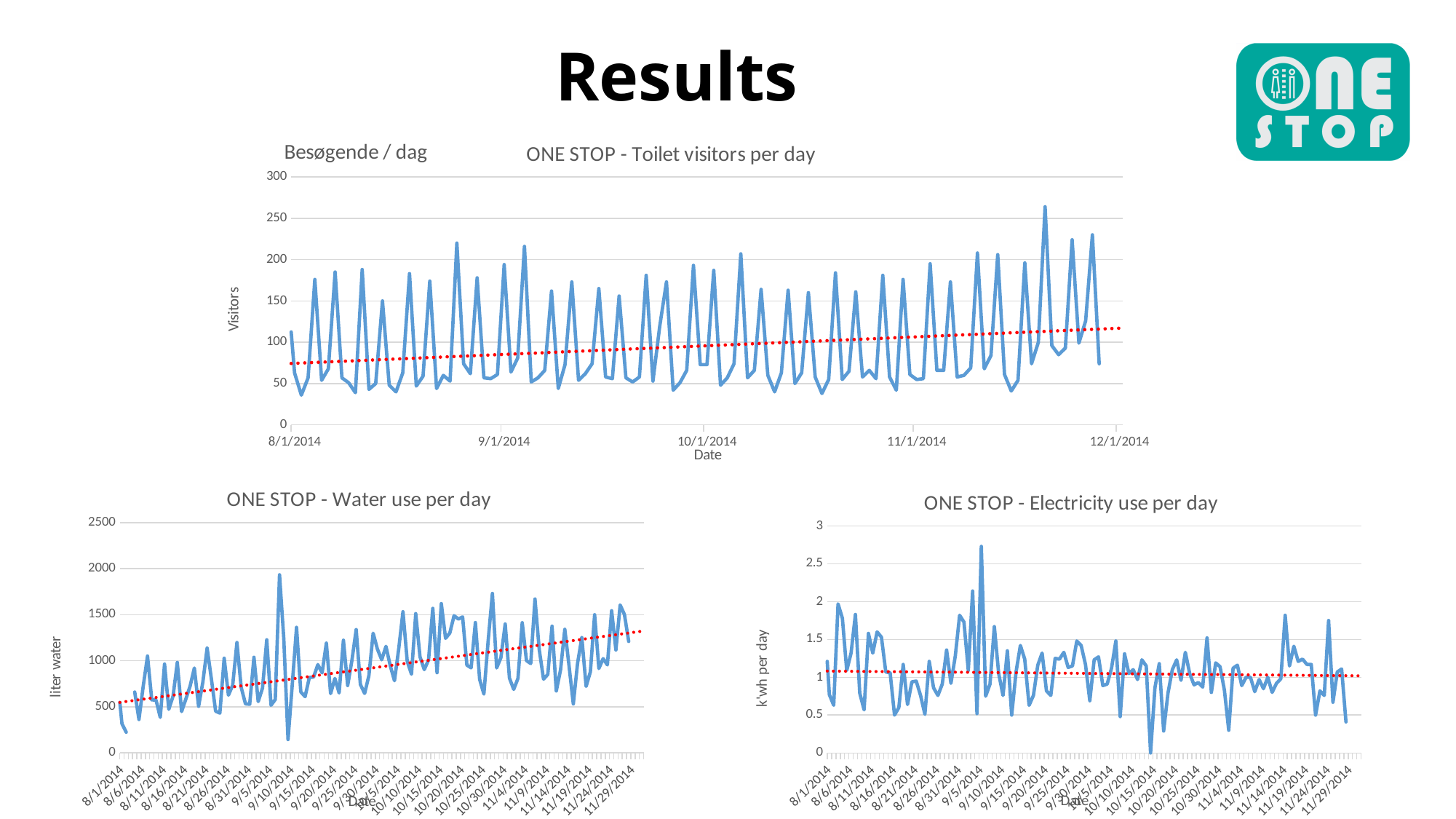
What is the y-axis label of the "ONE STOP - Water use per day" chart? liter water In the "ONE STOP - Water use per day" chart, does the dotted trend line rise or fall across the period shown? rise In the "ONE STOP - Toilet visitors per day" chart, does the dotted trend line rise or fall from August to December 2014? rise In the "ONE STOP - Electricity use per day" chart, is the highest peak near 9/5/2014 greater or less than 2.5? greater What colour is the dotted trend line in the "ONE STOP - Electricity use per day" chart? red What kind of chart is "ONE STOP - Toilet visitors per day"? line chart How many charts are shown on the slide? 3 In the "ONE STOP - Toilet visitors per day" chart, is the highest peak in late November 2014 greater or less than 250? greater In the "ONE STOP - Electricity use per day" chart, is the lowest dip near 10/15/2014 greater or less than 0.5? less